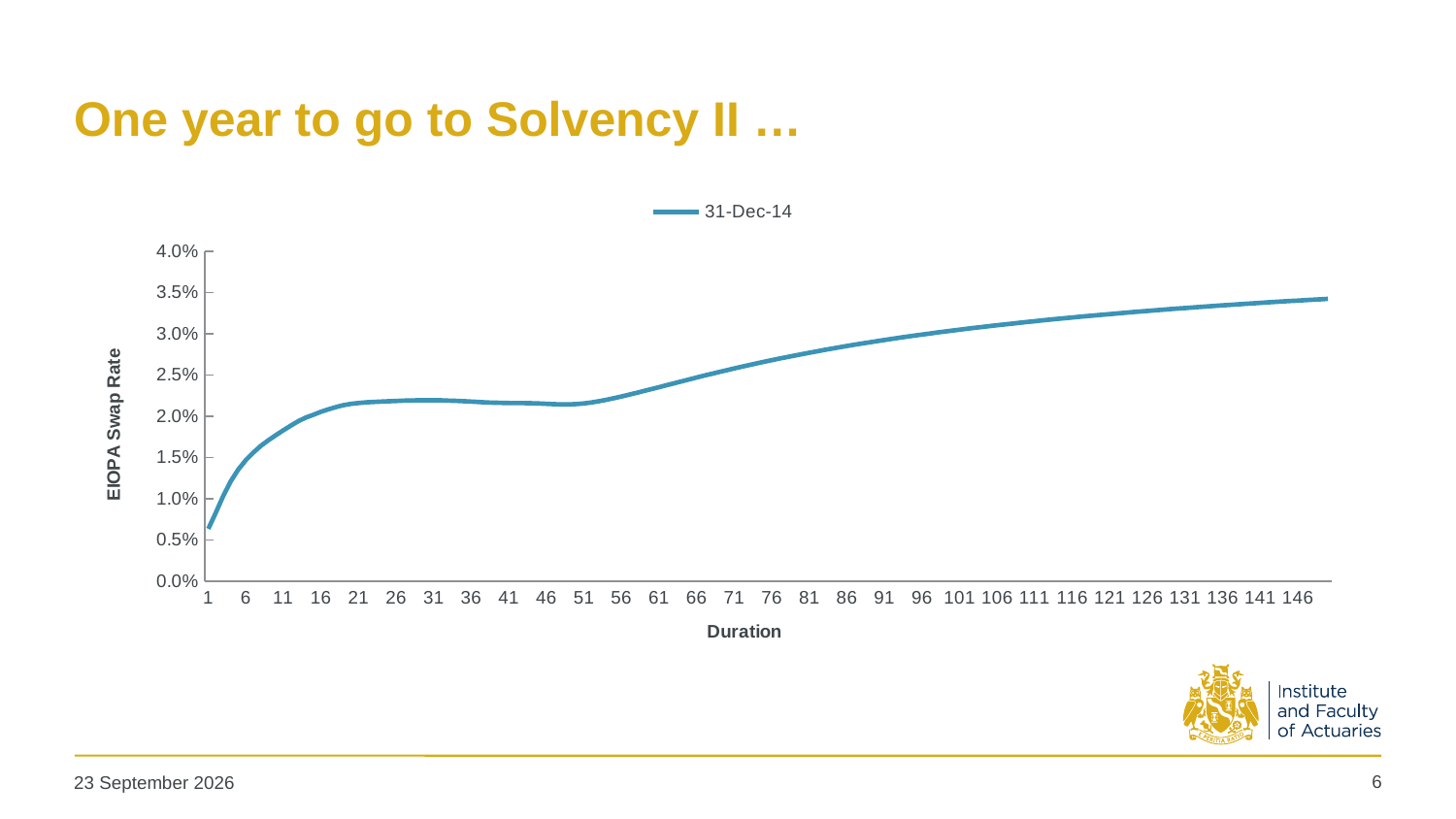
Is the swap rate at duration 146 greater or less than 3.0%? greater Overall, does the EIOPA swap rate rise or fall as duration increases from 1 to 146? rise Is the swap rate at duration 11 greater or less than 2.0%? less At which duration is the EIOPA swap rate lowest? 1 Which is larger, the swap rate at duration 146 or at duration 51? duration 146 Is the swap rate at duration 76 greater or less than 2.5%? greater What is the title of the vertical axis? EIOPA Swap Rate What is the name of the series shown in the legend? 31-Dec-14 How many series does the chart legend list? 1 What kind of chart is shown on the slide? line chart